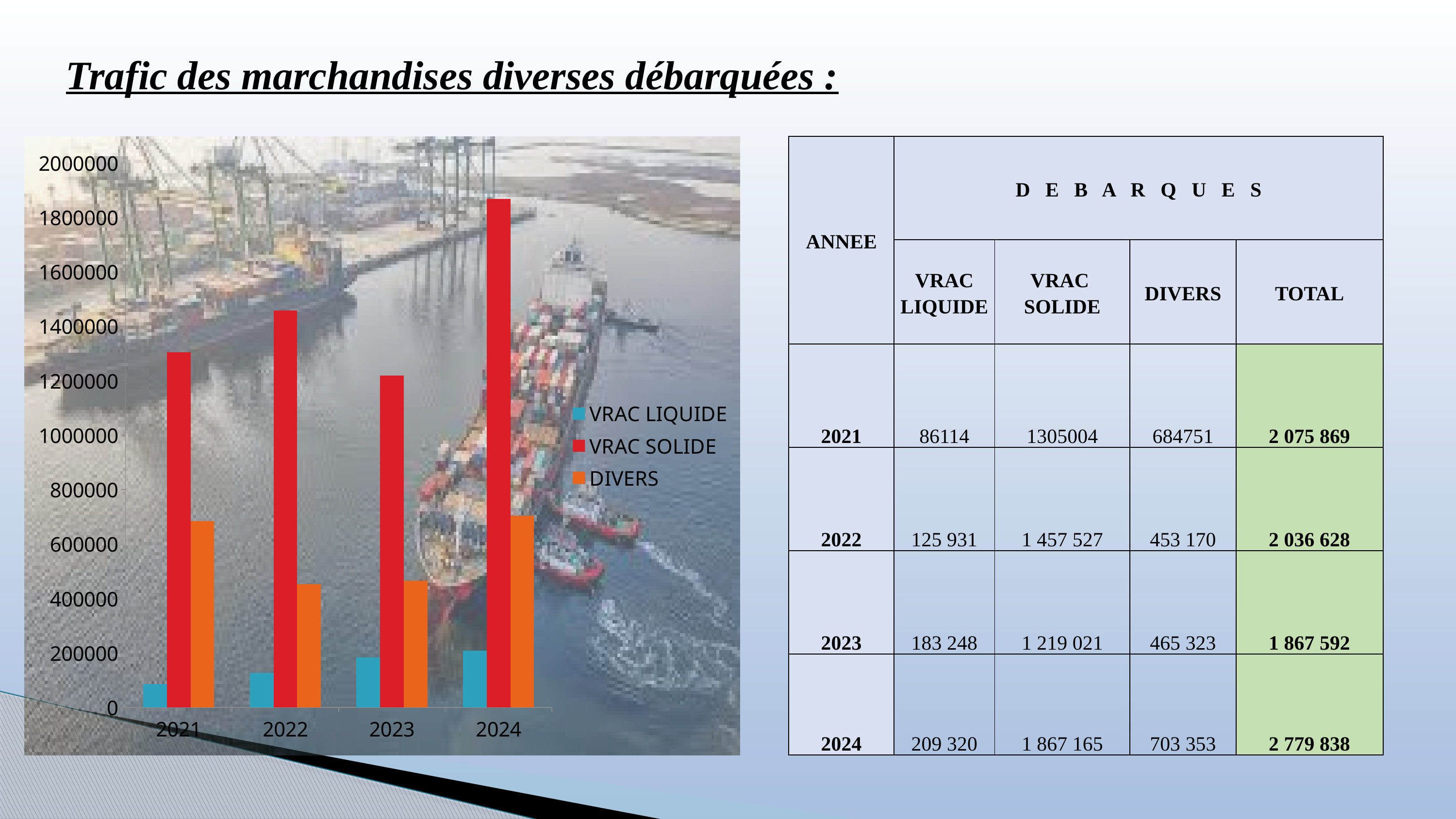
What kind of chart is shown on the slide? bar chart Is the VRAC SOLIDE bar for 2024 greater or less than 1800000? greater What colour are the VRAC SOLIDE bars in the chart? red According to the table on the slide, what is the VRAC SOLIDE value for 2024? 1 867 165 According to the table on the slide, what is the TOTAL for 2023? 1 867 592 How many series does the chart legend list? 3 Which is larger in the chart: the DIVERS bar for 2021 or the DIVERS bar for 2022? 2021 Do the VRAC LIQUIDE bars rise or fall from 2021 to 2024? rise In which year is the VRAC LIQUIDE bar the lowest? 2021 Is the DIVERS bar for 2022 greater or less than 600000? less In which year is the VRAC SOLIDE bar the highest? 2024 How many years are shown on the x axis of the chart? 4